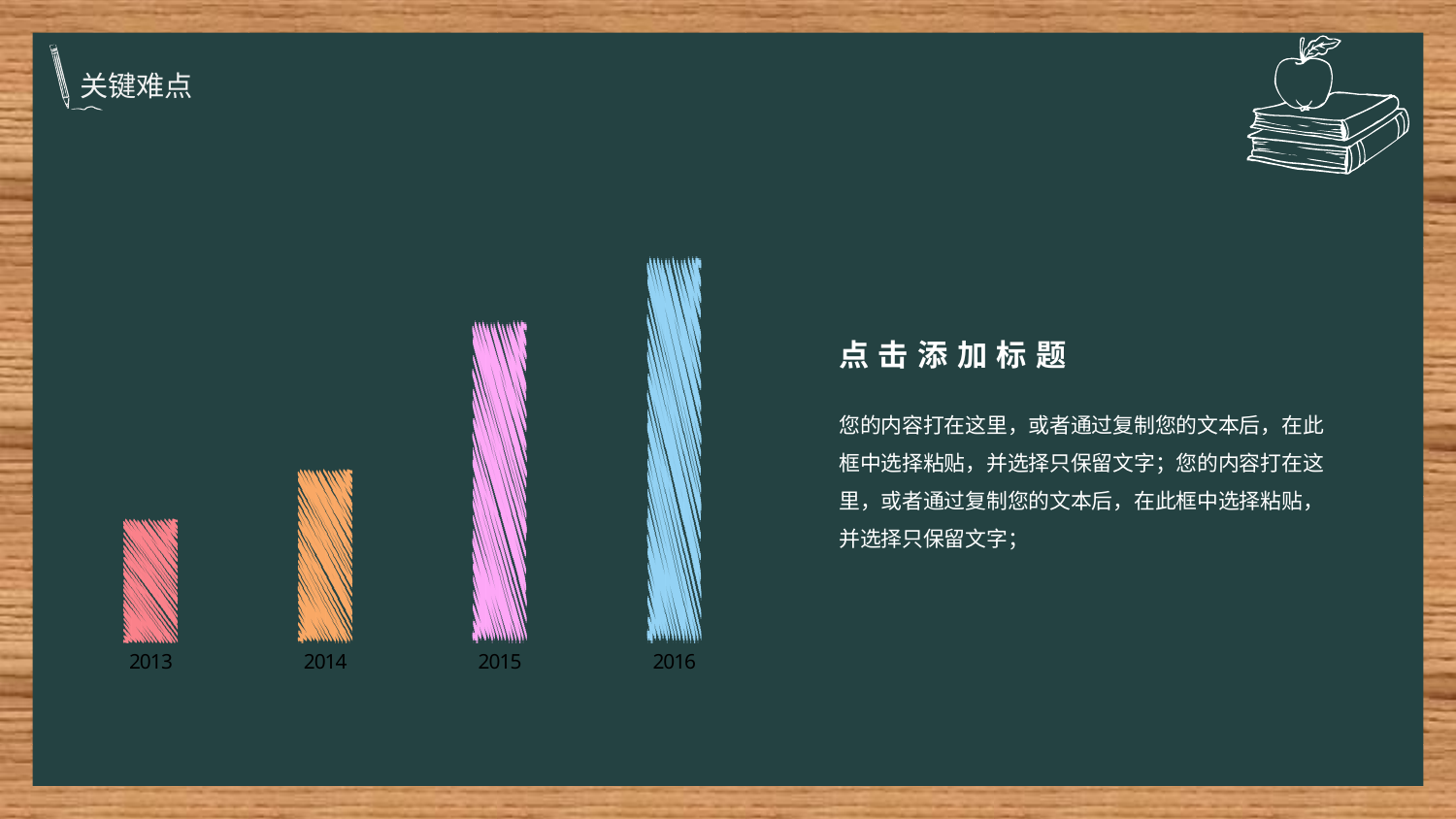
What kind of chart is shown on the slide? bar chart What are the category labels on the x axis of the chart? 2013, 2014, 2015, 2016 Which is larger, the bar for 2014 or the bar for 2015? 2015 What colour is the bar for 2016? blue Do the bar heights rise or fall from 2013 to 2016? rise Which year has the shortest bar? 2013 Which is larger, the bar for 2013 or the bar for 2014? 2014 Which year has the tallest bar? 2016 How many bars does the chart have? 4